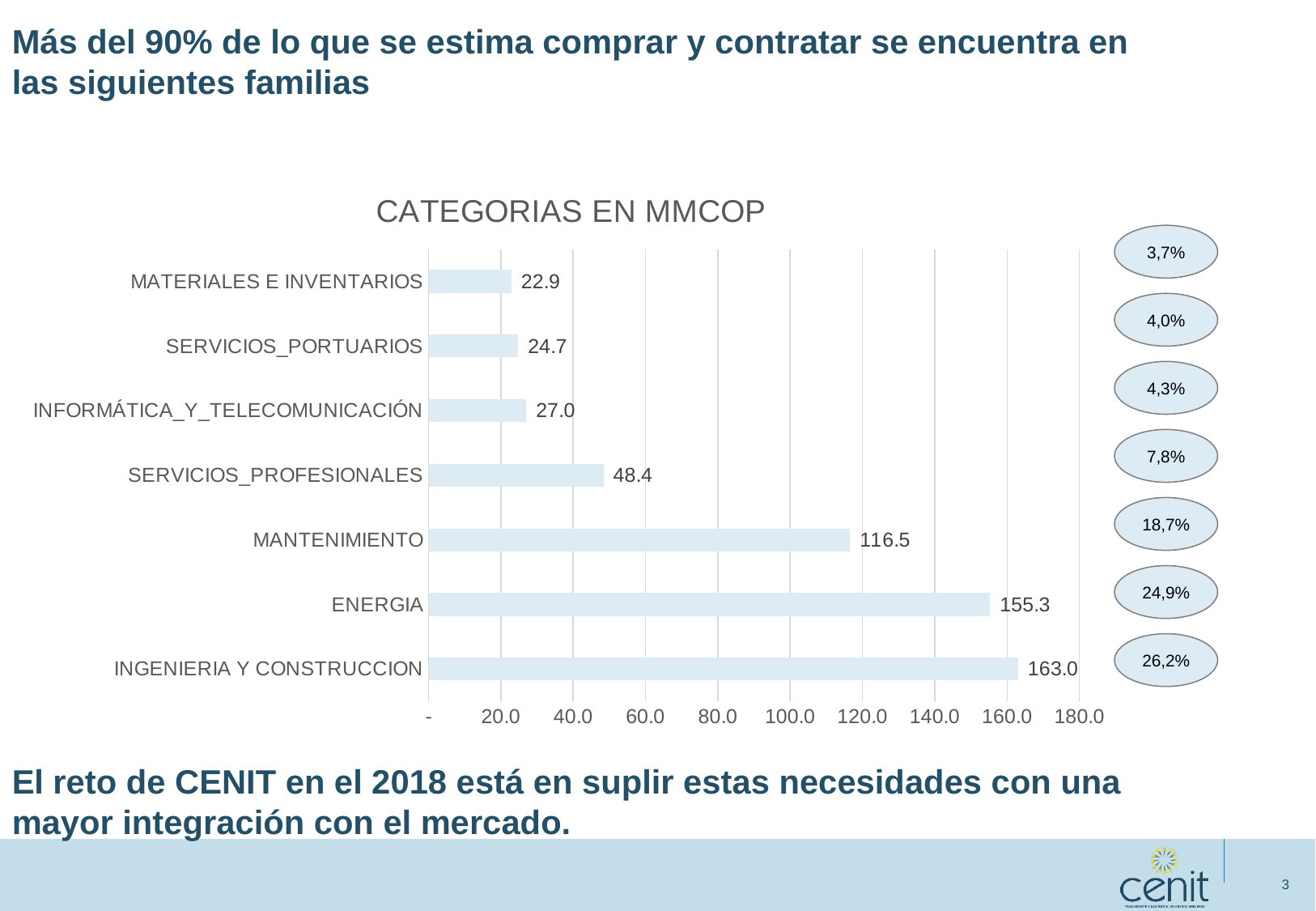
Which is larger, the value for SERVICIOS_PORTUARIOS or the value for MATERIALES E INVENTARIOS? SERVICIOS_PORTUARIOS What is the title of the chart? CATEGORIAS EN MMCOP What is the value for INFORMÁTICA_Y_TELECOMUNICACIÓN? 27.0 Which category has the lowest value? MATERIALES E INVENTARIOS What kind of chart is shown on the slide? bar chart What is the value for SERVICIOS_PROFESIONALES? 48.4 What is the difference between the values for MANTENIMIENTO and SERVICIOS_PROFESIONALES? 68.1 How many categories are shown in the chart? 7 What is the value for MANTENIMIENTO in the CATEGORIAS EN MMCOP chart? 116.5 What is the difference between the values for INGENIERIA Y CONSTRUCCION and ENERGIA? 7.7 Which category has the highest value? INGENIERIA Y CONSTRUCCION Is the value for ENERGIA greater or less than 140.0? greater